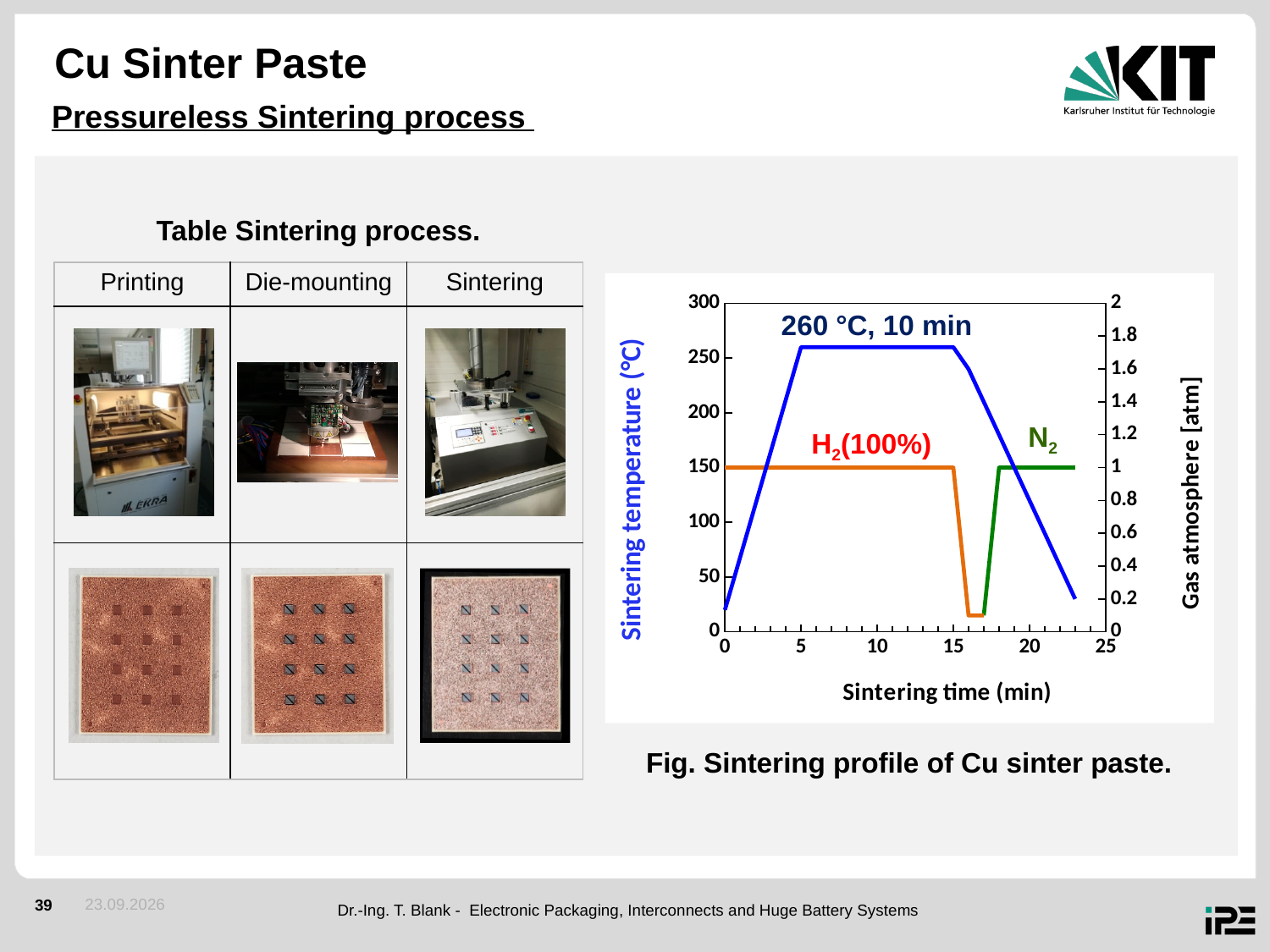
In the sintering profile chart, is the sintering temperature at 20 min greater or less than 150? less In the sintering profile chart, which gas is present at 20 min, H2 or N2? N2 What is the label of the x axis in the sintering profile chart? Sintering time (min) How many lines (series) are plotted in the sintering profile chart? 3 In the sintering profile chart, which gas is present at 10 min, H2 or N2? H2 In the sintering profile chart, is the sintering temperature at 2 min greater or less than 150? less In the sintering profile chart, is the sintering temperature at 10 min greater or less than 200? greater What kind of chart is shown in the figure 'Sintering profile of Cu sinter paste'? line chart What is the peak sintering temperature shown in the sintering profile chart? 260 °C In the sintering profile chart, does the sintering temperature rise or fall between 15 and 23 min? fall In the sintering profile chart, does the sintering temperature rise or fall between 0 and 5 min? rise For how long is the sintering temperature held at 260 °C according to the chart annotation? 10 min